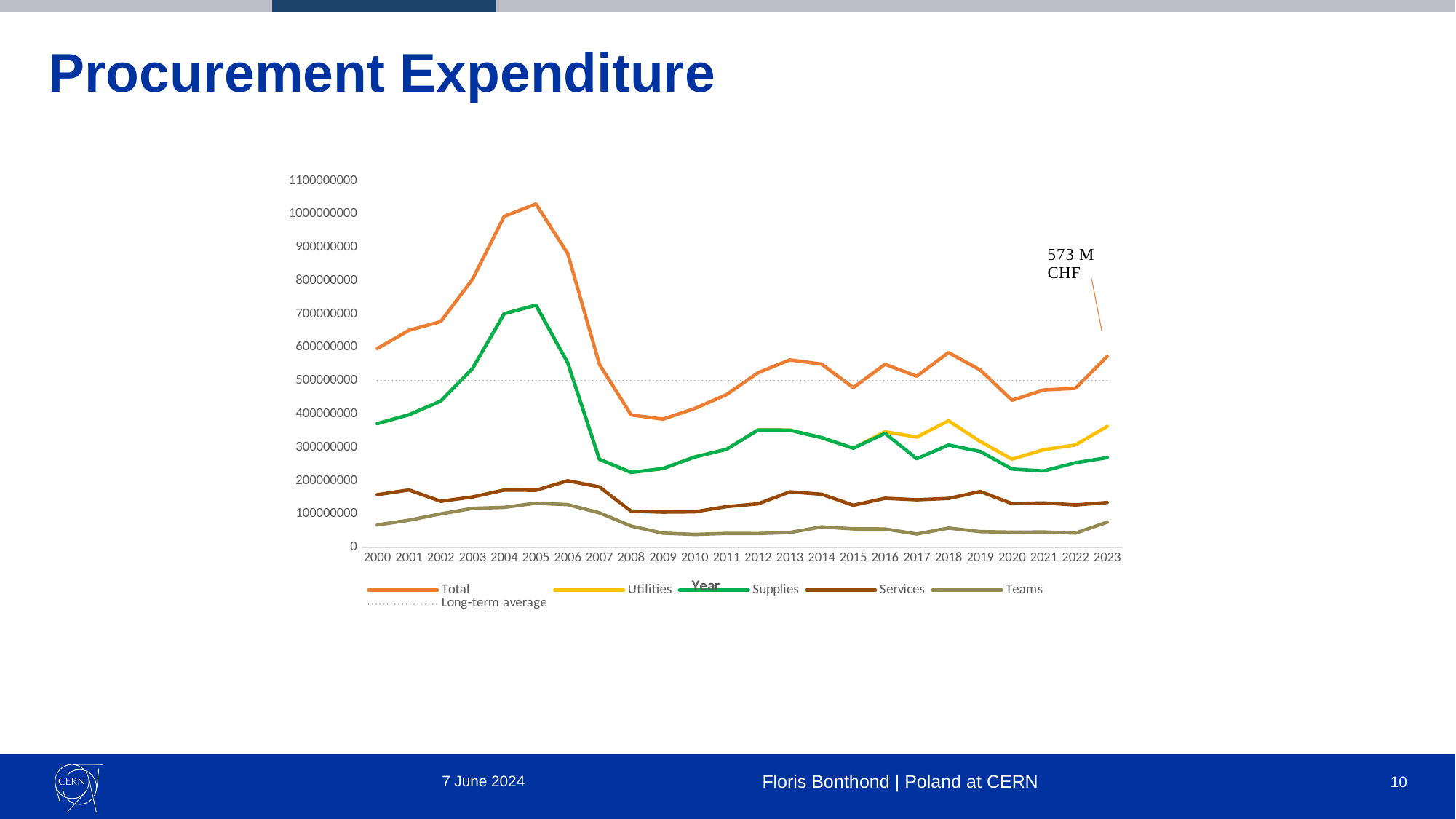
How many years are shown on the x axis? 24 Is the value for Supplies in 2005 greater or less than 600000000? greater Is the value for Total in 2009 greater or less than 500000000? less How many series does the legend list? 6 What value does the annotation give for Total expenditure in 2023? 573 M CHF Is the value for Total in 2005 greater or less than 900000000? greater What kind of chart is shown on the slide? line chart In which year does the Total series reach its highest value? 2005 In 2010, which is larger, Services or Teams? Services Which series is drawn as a dotted line? Long-term average Does the Total series rise or fall from 2005 to 2008? fall In 2023, which is larger, Utilities or Supplies? Utilities